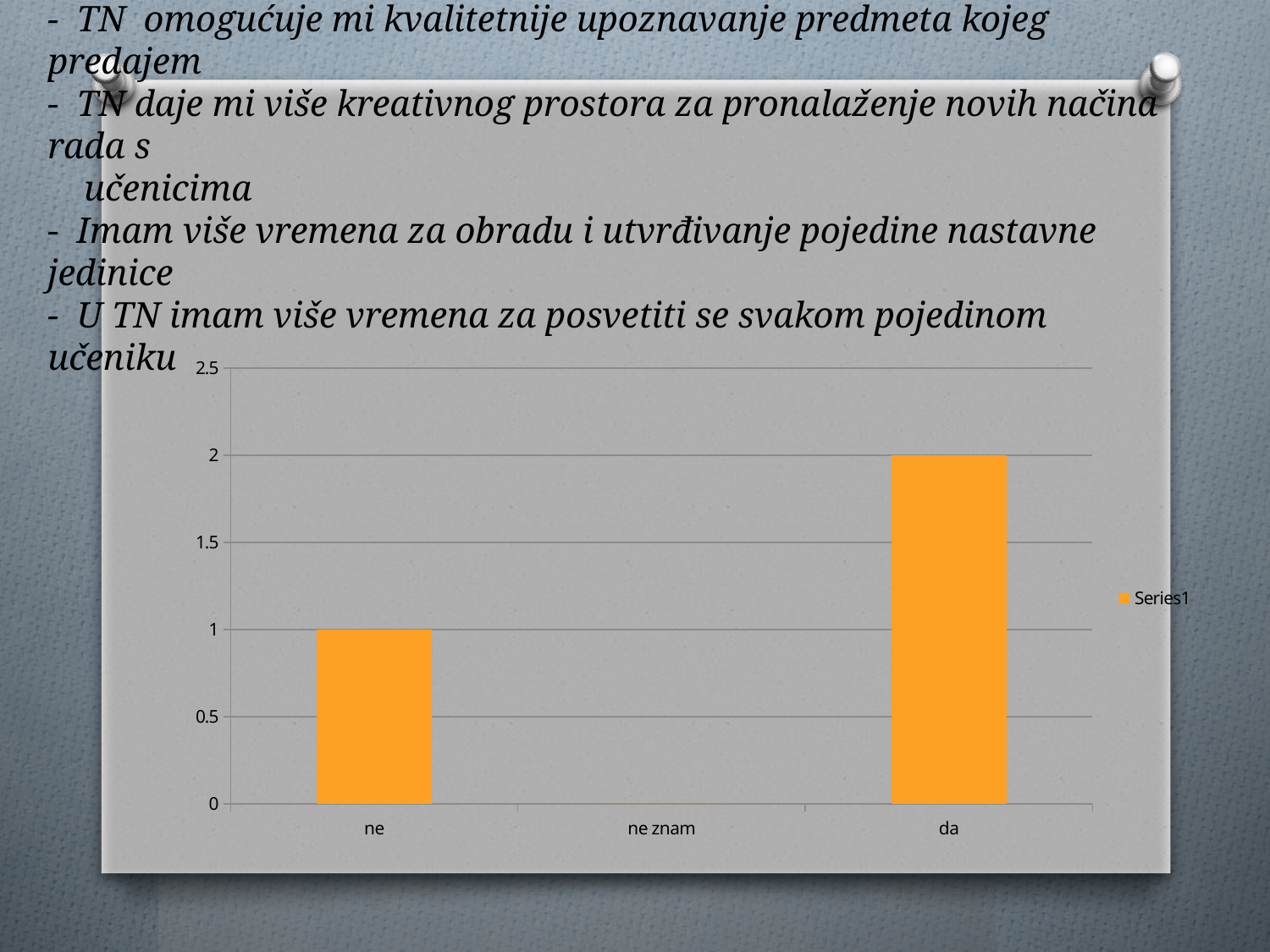
What is the name of the series shown in the legend? Series1 What is the value for "ne znam"? 0 Which is larger, the value for "ne" or the value for "da"? da What is the difference between the values for "da" and "ne"? 1 Is the value for "da" greater or less than 1.5? greater What is the value for "da"? 2 How many series does the legend list? 1 Which category has the lowest value? ne znam What is the value for "ne"? 1 What kind of chart is shown on the slide? bar chart How many categories are shown on the x axis? 3 Which category has the highest value? da